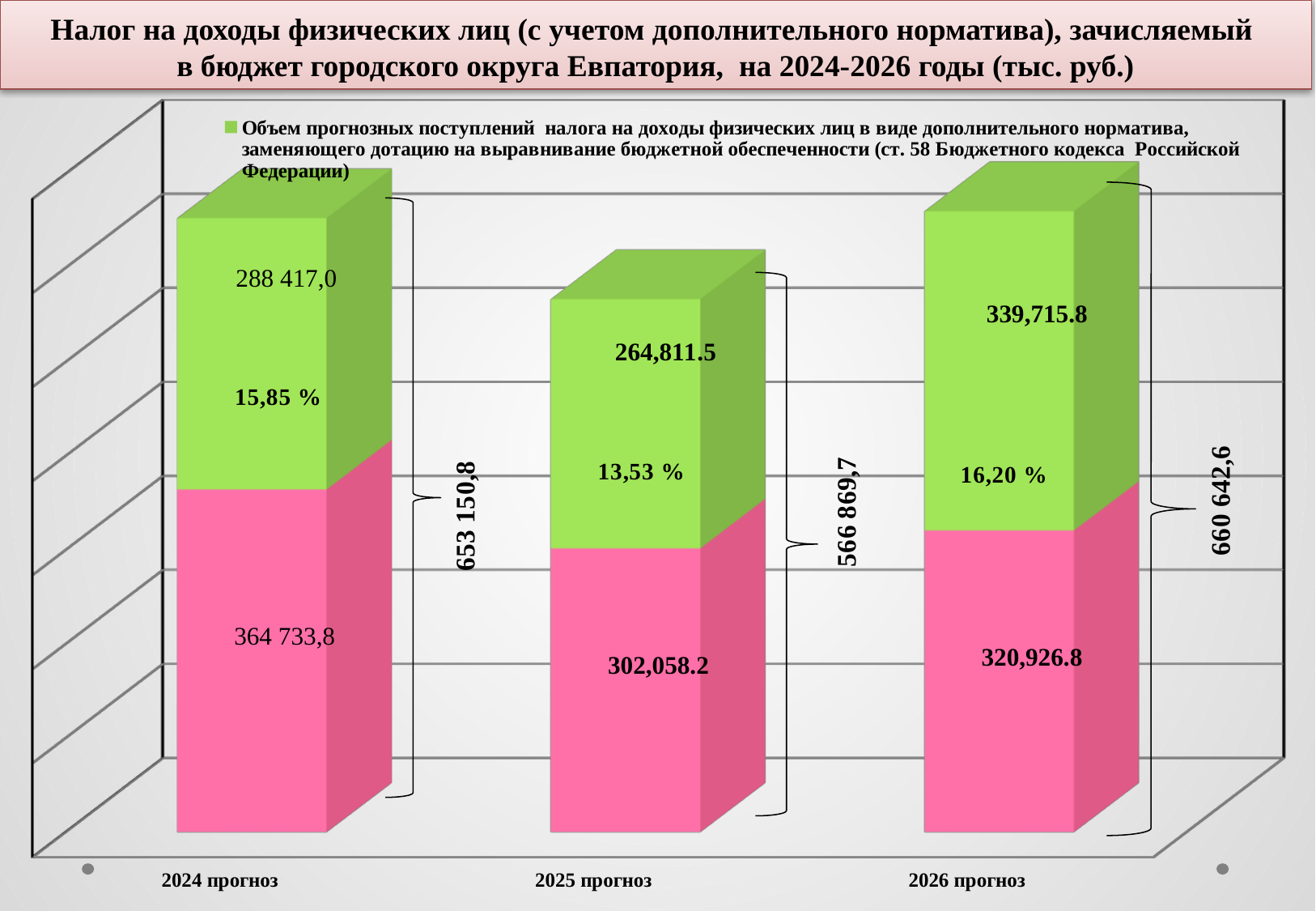
What is the value of the green segment for 2026 прогноз? 339,715.8 How many series does the chart legend list? 1 What is the value of the green segment for 2024 прогноз? 288 417,0 What percentage is shown on the green segment for 2025 прогноз? 13,53 % What type of chart is shown on the slide? bar chart How many categories (years) are shown on the x axis of the chart? 3 Which year has the lowest total bar value? 2025 прогноз What is the value of the pink segment for 2025 прогноз? 302,058.2 What is the total shown for the 2024 прогноз bar? 653 150,8 What colour is the series listed in the chart legend? green What is the total shown for the 2026 прогноз bar? 660 642,6 Which is larger: the pink segment for 2024 прогноз or the pink segment for 2026 прогноз? 2024 прогноз